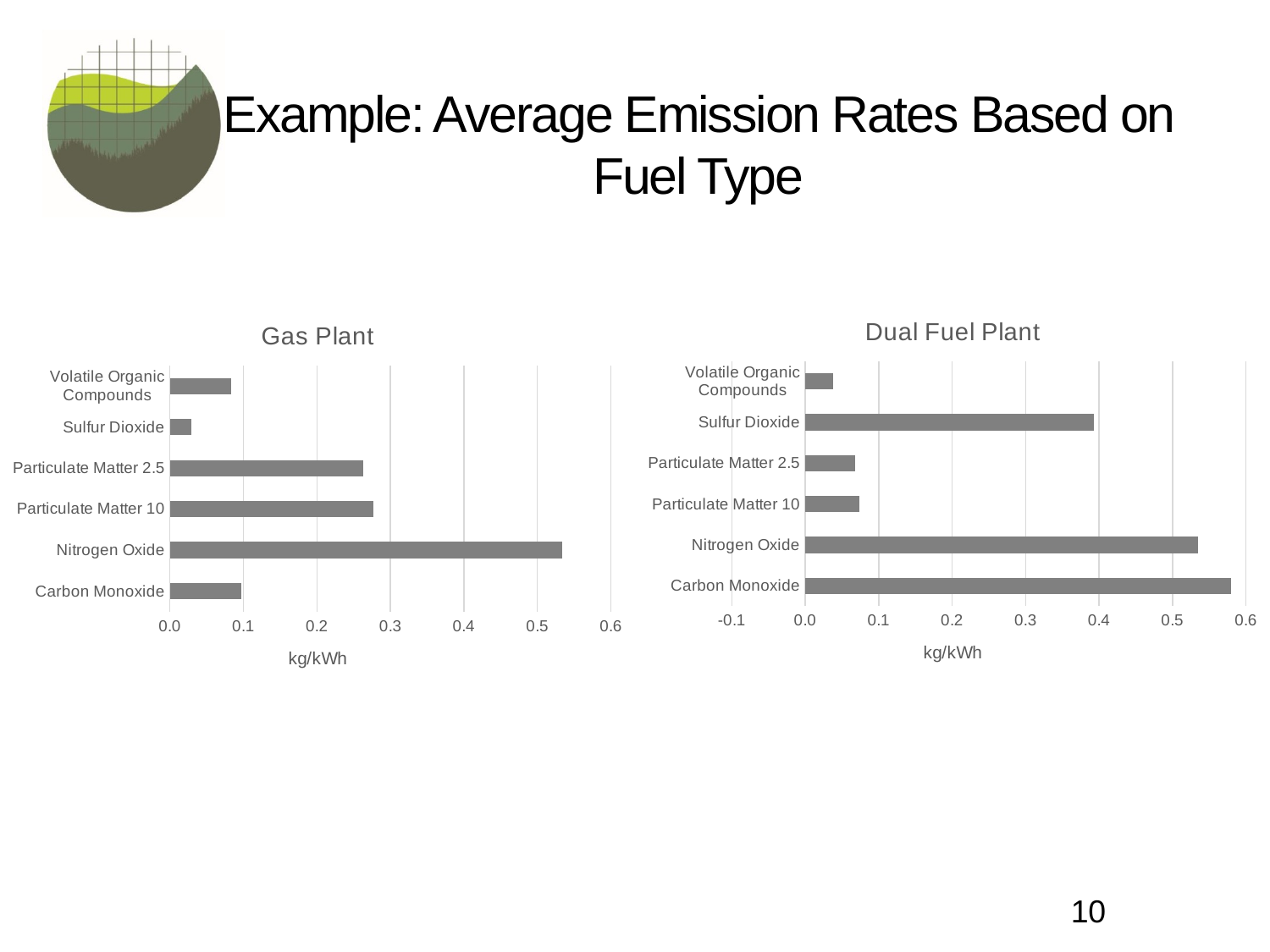
In the Gas Plant chart, which category has the lowest emission rate? Sulfur Dioxide In the Dual Fuel Plant chart, which is larger, Sulfur Dioxide or Particulate Matter 10? Sulfur Dioxide In the Dual Fuel Plant chart, which category has the lowest emission rate? Volatile Organic Compounds How many categories are shown in the Gas Plant chart? 6 What kind of chart is the Gas Plant chart? bar chart What unit is shown on the x axis of the Dual Fuel Plant chart? kg/kWh In the Dual Fuel Plant chart, which category has the highest emission rate? Carbon Monoxide In the Gas Plant chart, which category has the highest emission rate? Nitrogen Oxide In the Gas Plant chart, which is larger, Particulate Matter 2.5 or Volatile Organic Compounds? Particulate Matter 2.5 In the Gas Plant chart, is the value for Nitrogen Oxide greater or less than 0.5? greater In the Dual Fuel Plant chart, is the value for Sulfur Dioxide greater or less than 0.3? greater In the Gas Plant chart, is the value for Carbon Monoxide greater or less than 0.2? less